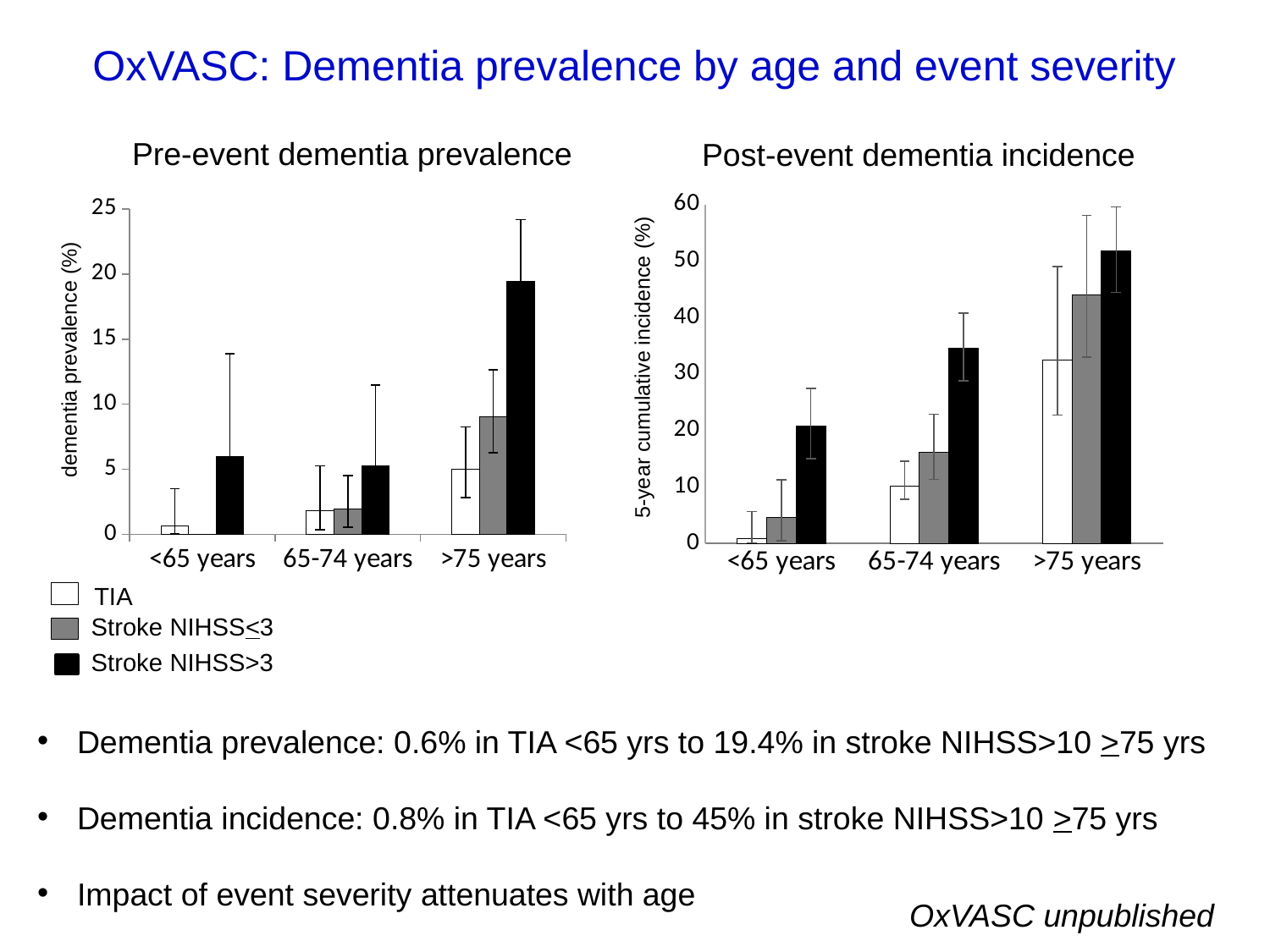
How many series does the legend list for the charts? 3 In the 'Post-event dementia incidence' chart, do the Stroke NIHSS>3 values rise or fall as age group increases? rise In the 'Pre-event dementia prevalence' chart, is the value for Stroke NIHSS>3 in the <65 years group greater or less than 10? less What is the y-axis label of the 'Post-event dementia incidence' chart? 5-year cumulative incidence (%) How many age-group categories are shown on the x axis of the 'Post-event dementia incidence' chart? 3 In the 'Pre-event dementia prevalence' chart, which series and age group has the highest bar? Stroke NIHSS>3, >75 years In the 'Post-event dementia incidence' chart, which series and age group has the lowest bar? TIA, <65 years In the 'Post-event dementia incidence' chart, is the value for Stroke NIHSS>3 in the >75 years group greater or less than 40? greater In the 'Post-event dementia incidence' chart, is the value for TIA in the 65-74 years group greater or less than 20? less What kind of chart is the 'Pre-event dementia prevalence' chart? bar chart In the 'Post-event dementia incidence' chart, for the >75 years group, which is larger: TIA or Stroke NIHSS>3? Stroke NIHSS>3